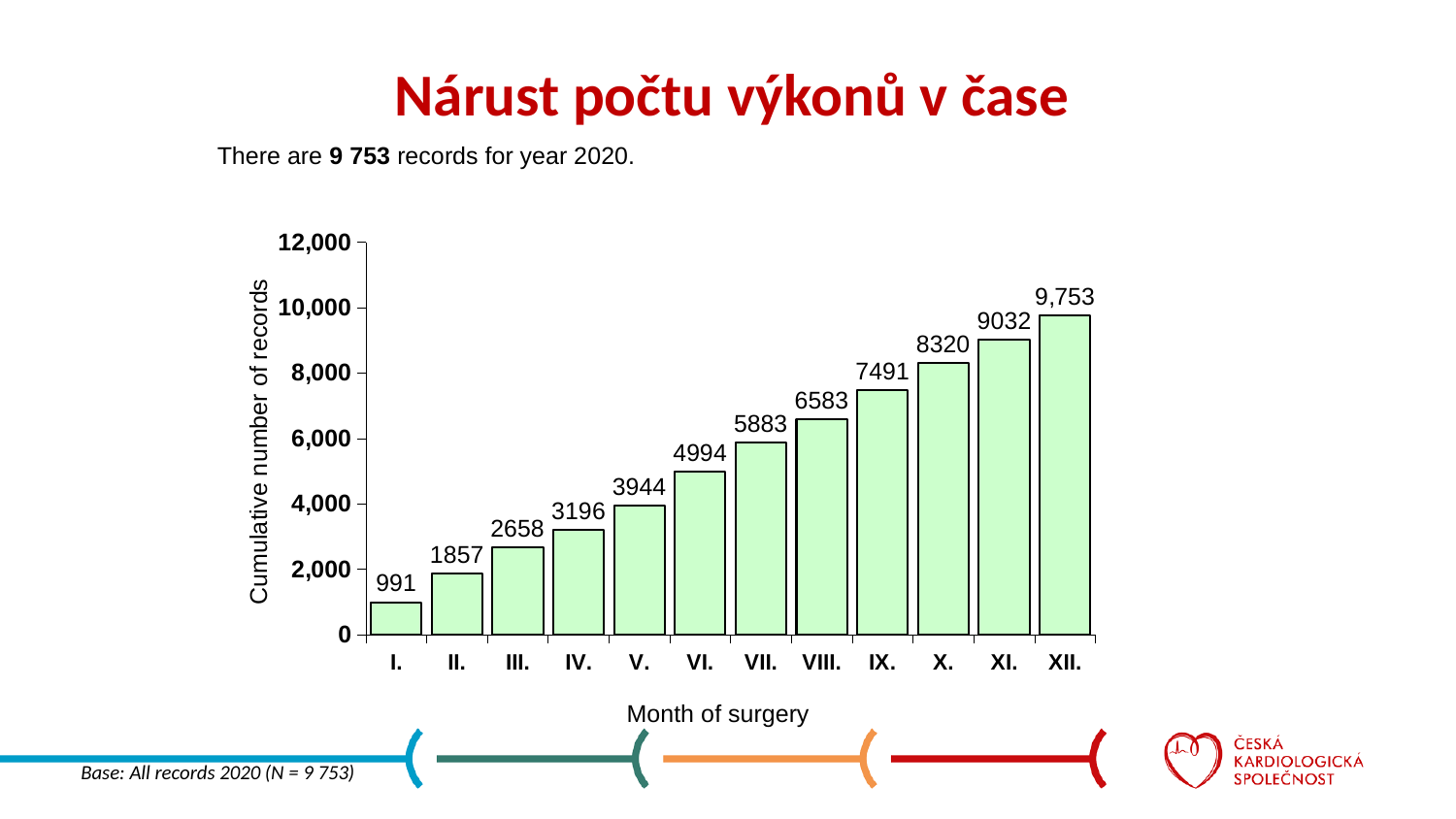
Which month has the lowest cumulative number of records? I. What is the difference between the cumulative number of records for month X. and month IX.? 829 Which month has the highest cumulative number of records? XII. Which is larger, the value for month V. or the value for month VIII.? VIII. What is the cumulative number of records for month XII.? 9,753 What is the difference between the cumulative number of records for month II. and month I.? 866 Is the value for month VII. greater or less than 6,000? less How many months are shown on the x axis? 12 Do the values rise or fall from month I. to month XII.? rise What is the cumulative number of records for month I.? 991 What is the cumulative number of records for month VI.? 4994 What kind of chart is shown on the slide? bar chart